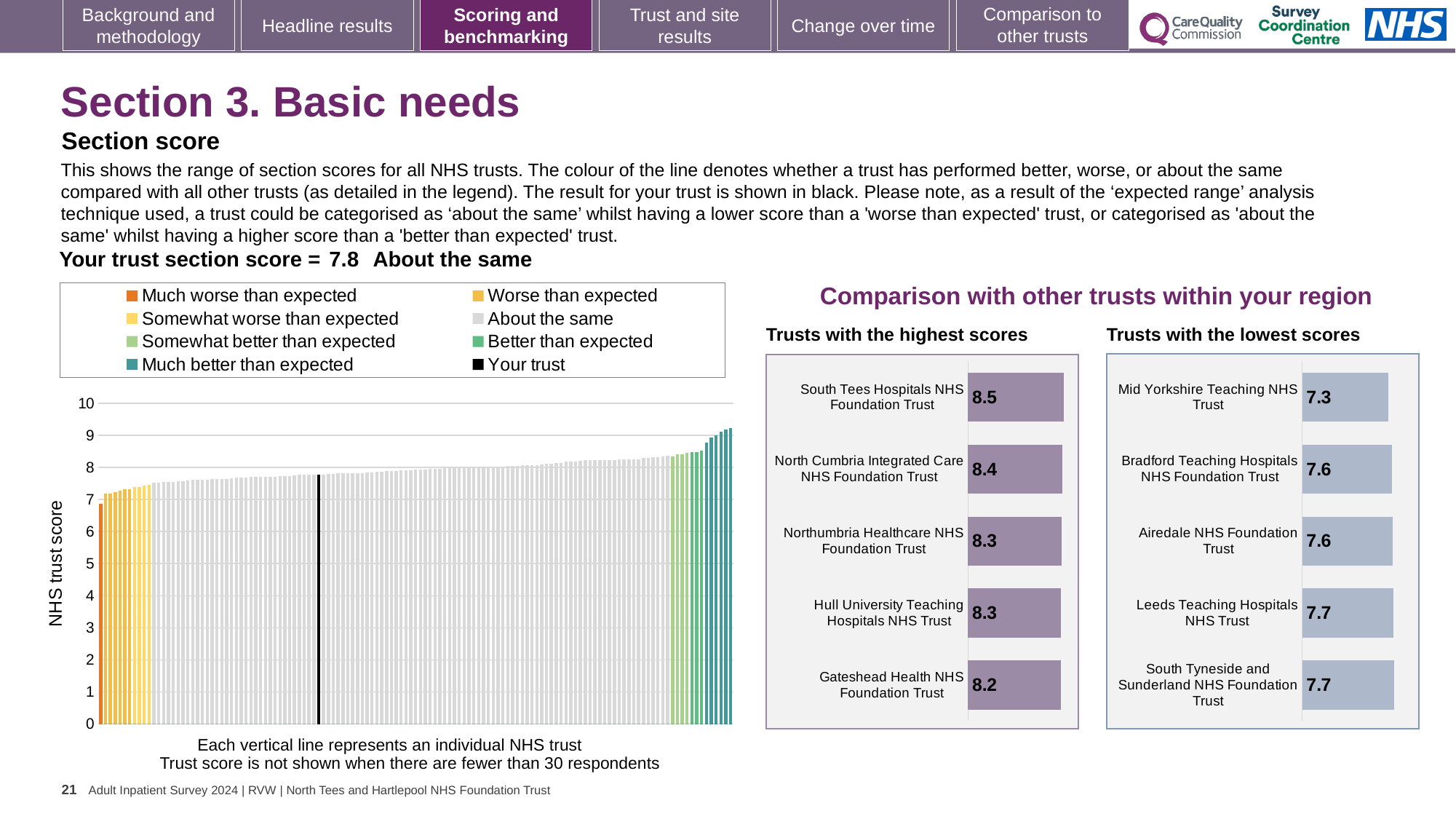
What kind of chart is the main chart on the left showing NHS trust scores? Bar chart How many trusts are shown on the 'Trusts with the lowest scores' chart? 5 On the 'Trusts with the lowest scores' chart, which trust has the lowest score? Mid Yorkshire Teaching NHS Trust On the 'Trusts with the highest scores' chart, what is the difference between the scores of South Tees Hospitals NHS Foundation Trust and Gateshead Health NHS Foundation Trust? 0.3 On the main chart on the left, what is the section score for your trust (the black bar)? 7.8 On the 'Trusts with the lowest scores' chart, what is the difference between the scores of Leeds Teaching Hospitals NHS Trust and Mid Yorkshire Teaching NHS Trust? 0.4 On the 'Trusts with the lowest scores' chart, what is the score for Mid Yorkshire Teaching NHS Trust? 7.3 On the 'Trusts with the highest scores' chart, what is the score for South Tees Hospitals NHS Foundation Trust? 8.5 How many entries does the legend of the main chart on the left list? 8 On the 'Trusts with the highest scores' chart, what is the score for Gateshead Health NHS Foundation Trust? 8.2 On the 'Trusts with the highest scores' chart, which has the larger score: Hull University Teaching Hospitals NHS Trust or Gateshead Health NHS Foundation Trust? Hull University Teaching Hospitals NHS Trust On the 'Trusts with the highest scores' chart, which trust has the highest score? South Tees Hospitals NHS Foundation Trust